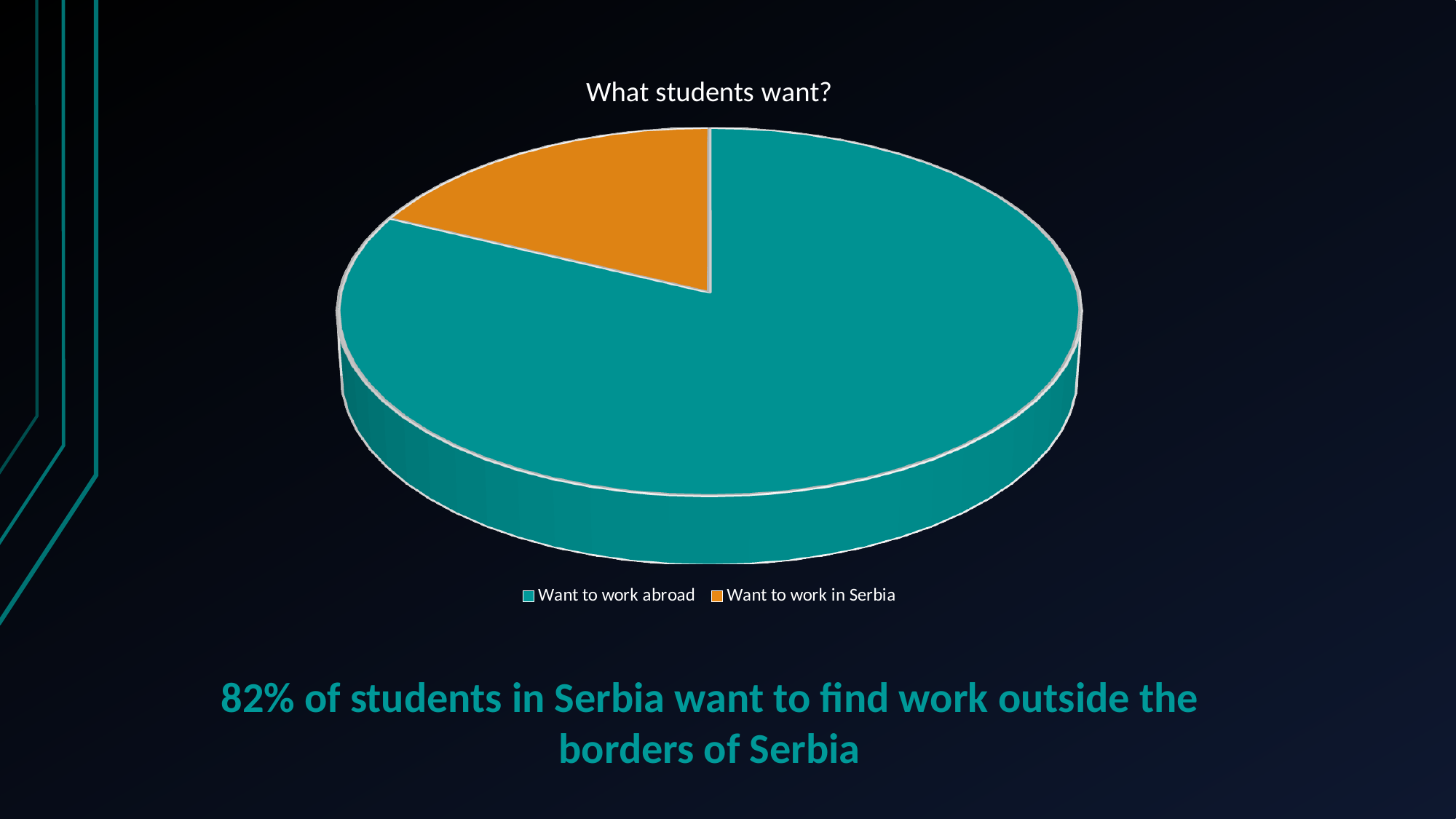
Which is larger: the slice for 'Want to work abroad' or the slice for 'Want to work in Serbia'? Want to work abroad What share of the pie does 'Want to work abroad' represent? 82% Which category has the largest slice of the pie? Want to work abroad What is the title of the chart? What students want? How many slices does the pie chart have? 2 Which category has the smallest slice of the pie? Want to work in Serbia What kind of chart is shown on the slide? pie chart What colour is the 'Want to work in Serbia' slice? orange How many entries does the legend list? 2